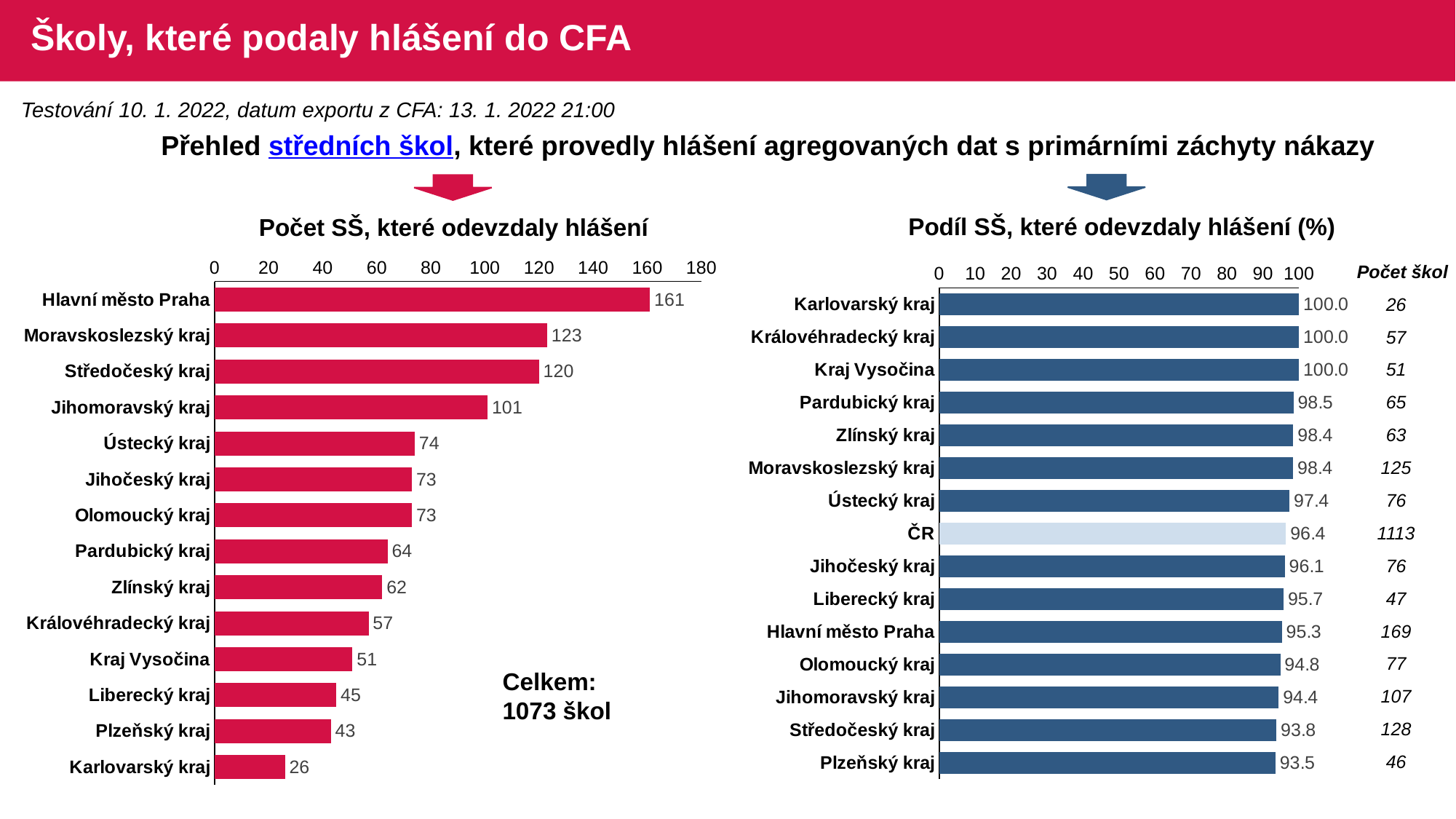
In the chart 'Počet SŠ, které odevzdaly hlášení', which region has the lowest value? Karlovarský kraj In the chart 'Počet SŠ, které odevzdaly hlášení', what is the difference between Moravskoslezský kraj and Středočeský kraj? 3 What type of chart is 'Počet SŠ, které odevzdaly hlášení'? bar chart In the chart 'Podíl SŠ, které odevzdaly hlášení (%)', what is the difference between Pardubický kraj and Středočeský kraj? 4.7 In the chart 'Počet SŠ, které odevzdaly hlášení', what is the value for Hlavní město Praha? 161 In the chart 'Podíl SŠ, které odevzdaly hlášení (%)', what is the value for ČR? 96.4 In the chart 'Počet SŠ, které odevzdaly hlášení', which is larger: Ústecký kraj or Pardubický kraj? Ústecký kraj In the chart 'Podíl SŠ, které odevzdaly hlášení (%)', which category has the lowest value? Plzeňský kraj How many bars are shown in the chart 'Podíl SŠ, které odevzdaly hlášení (%)'? 15 How many regions are shown in the chart 'Počet SŠ, které odevzdaly hlášení'? 14 In the chart 'Podíl SŠ, které odevzdaly hlášení (%)', what is the 'Počet škol' value listed for Moravskoslezský kraj? 125 In the chart 'Podíl SŠ, které odevzdaly hlášení (%)', what is the value for Ústecký kraj? 97.4